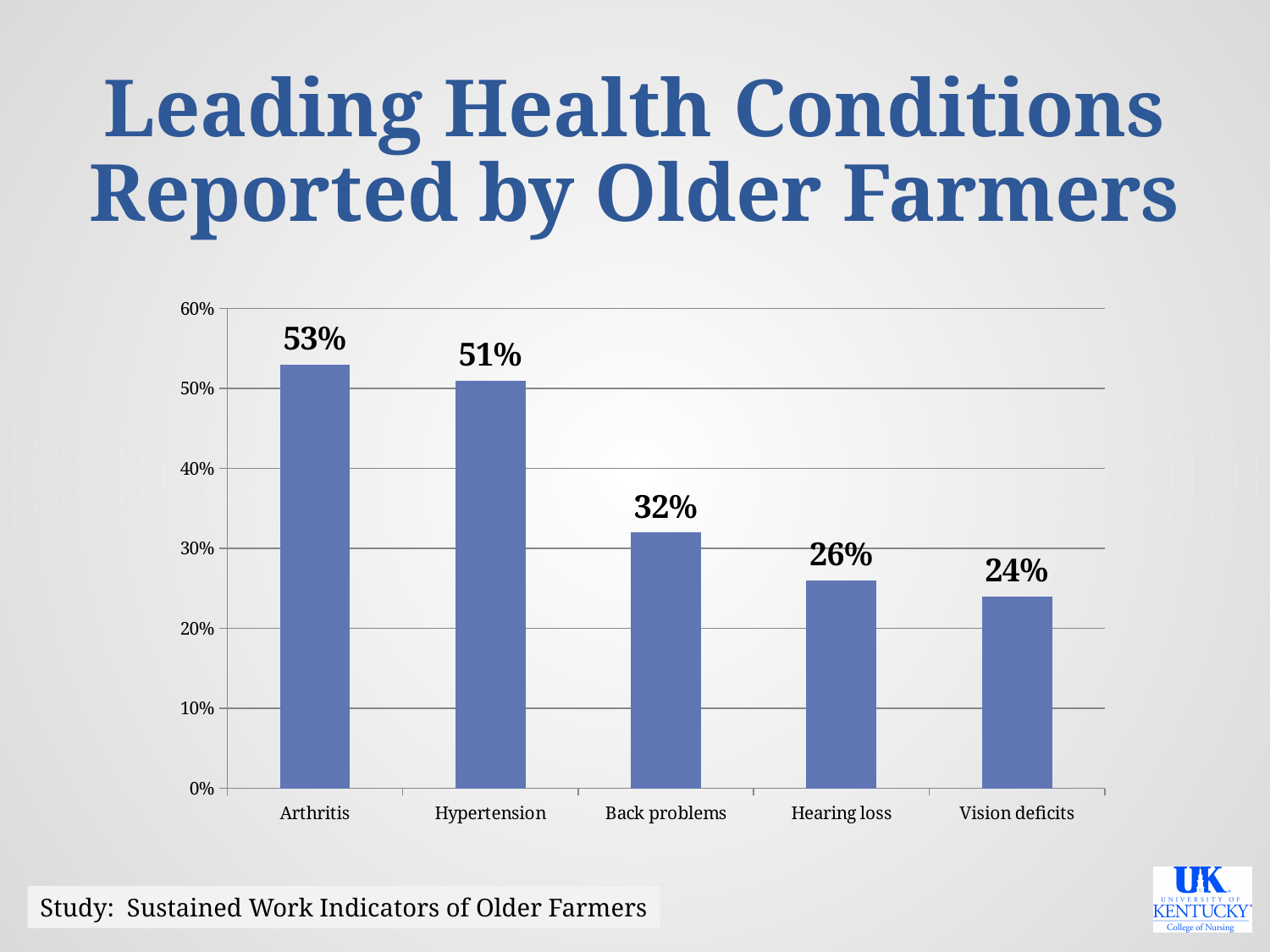
What is the value shown for Hypertension? 51% What is the value for Vision deficits? 24% What is the difference between the percentages for Arthritis and Back problems? 21% What is the difference between the values for Hearing loss and Vision deficits? 2% Which is larger, the value for Back problems or the value for Hearing loss? Back problems Which health condition has the lowest reported percentage? Vision deficits Which health condition has the highest reported percentage? Arthritis Is the value for Hypertension greater or less than 40%? greater How many health conditions are shown on the chart? 5 What percentage is shown for Back problems? 32% What percentage of older farmers reported arthritis? 53% What kind of chart is shown on the slide? Bar chart